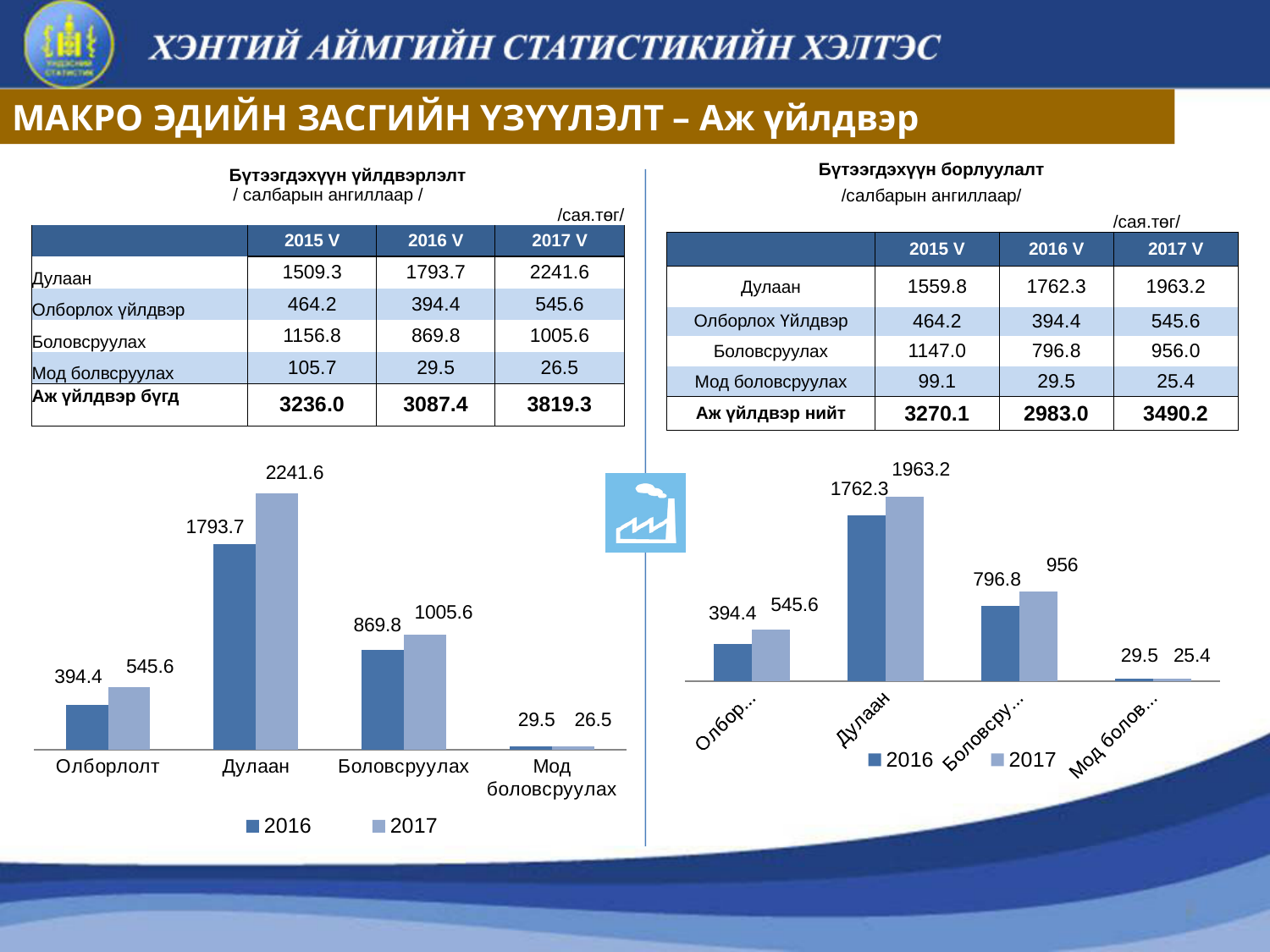
In the left chart, how many categories are shown on the x axis? 4 In the left chart, how many series does the legend list? 2 What type of chart is the right chart? bar chart In the right chart, what is the difference between the 2017 and 2016 values for Дулаан? 200.9 In the right chart, what are the two series listed in the legend? 2016 and 2017 In the left chart, what is the 2016 value for Боловсруулах? 869.8 In the left chart, what is the 2017 value for Дулаан? 2241.6 In the left chart, which category has the highest 2017 value? Дулаан In the right chart, what is the 2017 value for Дулаан? 1963.2 In the left chart, what is the difference between the 2017 and 2016 values for Олборлолт? 151.2 In the left chart, is the 2016 value for Мод боловсруулах larger or smaller than its 2017 value? larger In the left chart, which category has the lowest 2016 value? Мод боловсруулах